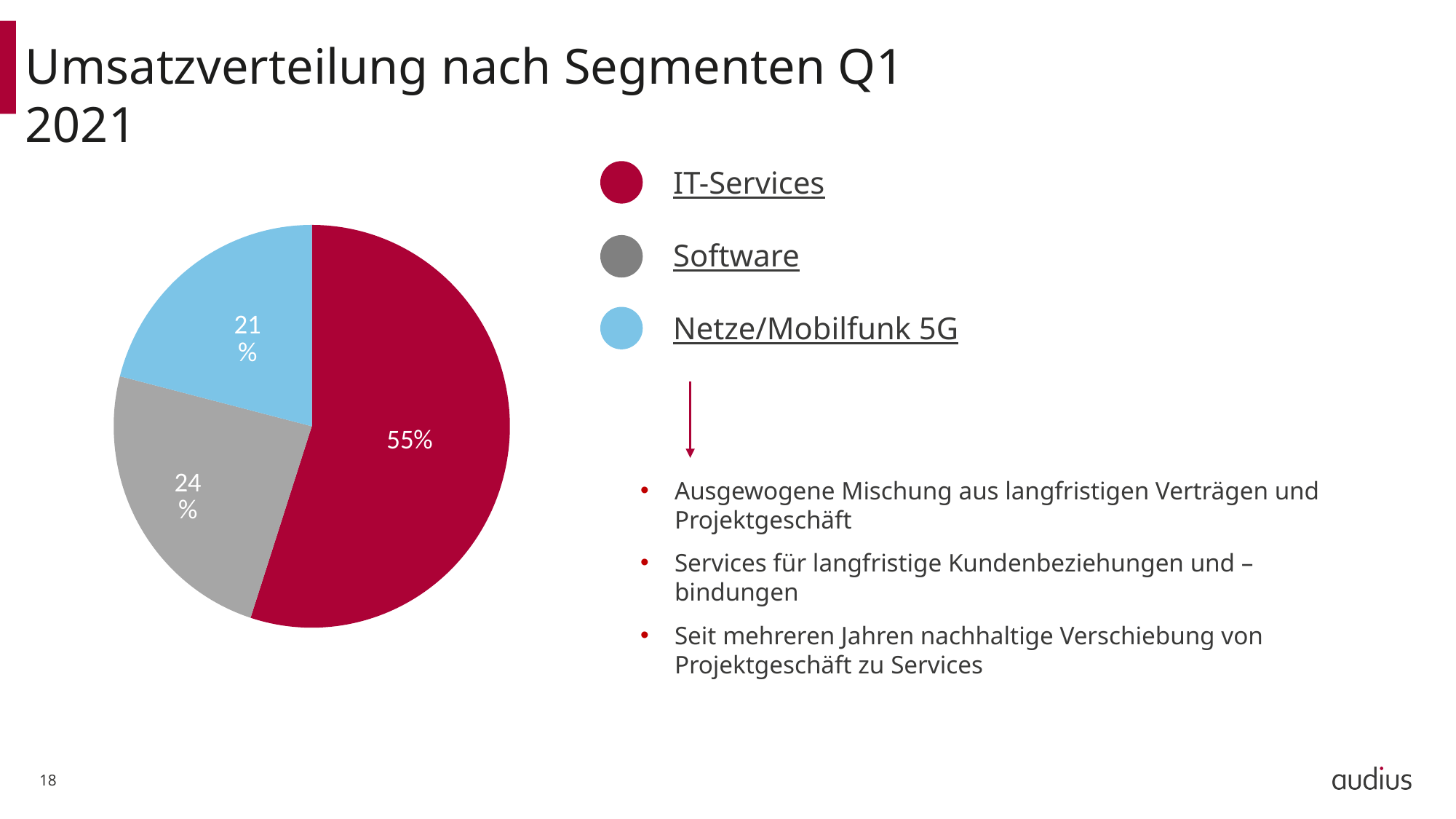
What is the difference in percentage points between the Software share and the Netze/Mobilfunk 5G share? 3 Which segment has the largest share in the pie chart? IT-Services Which segment has the smallest share in the pie chart? Netze/Mobilfunk 5G What kind of chart is shown on the slide? Pie chart How many segments are shown in the pie chart? 3 What share of the pie chart does Software represent? 24% What share of revenue does IT-Services account for in the pie chart? 55% What colour is the IT-Services slice in the pie chart? Red What is the title of the slide containing the pie chart? Umsatzverteilung nach Segmenten Q1 2021 What is the difference in percentage points between the IT-Services share and the Software share? 31 What share of the pie chart does Netze/Mobilfunk 5G represent? 21% Which has a larger share, Software or Netze/Mobilfunk 5G? Software